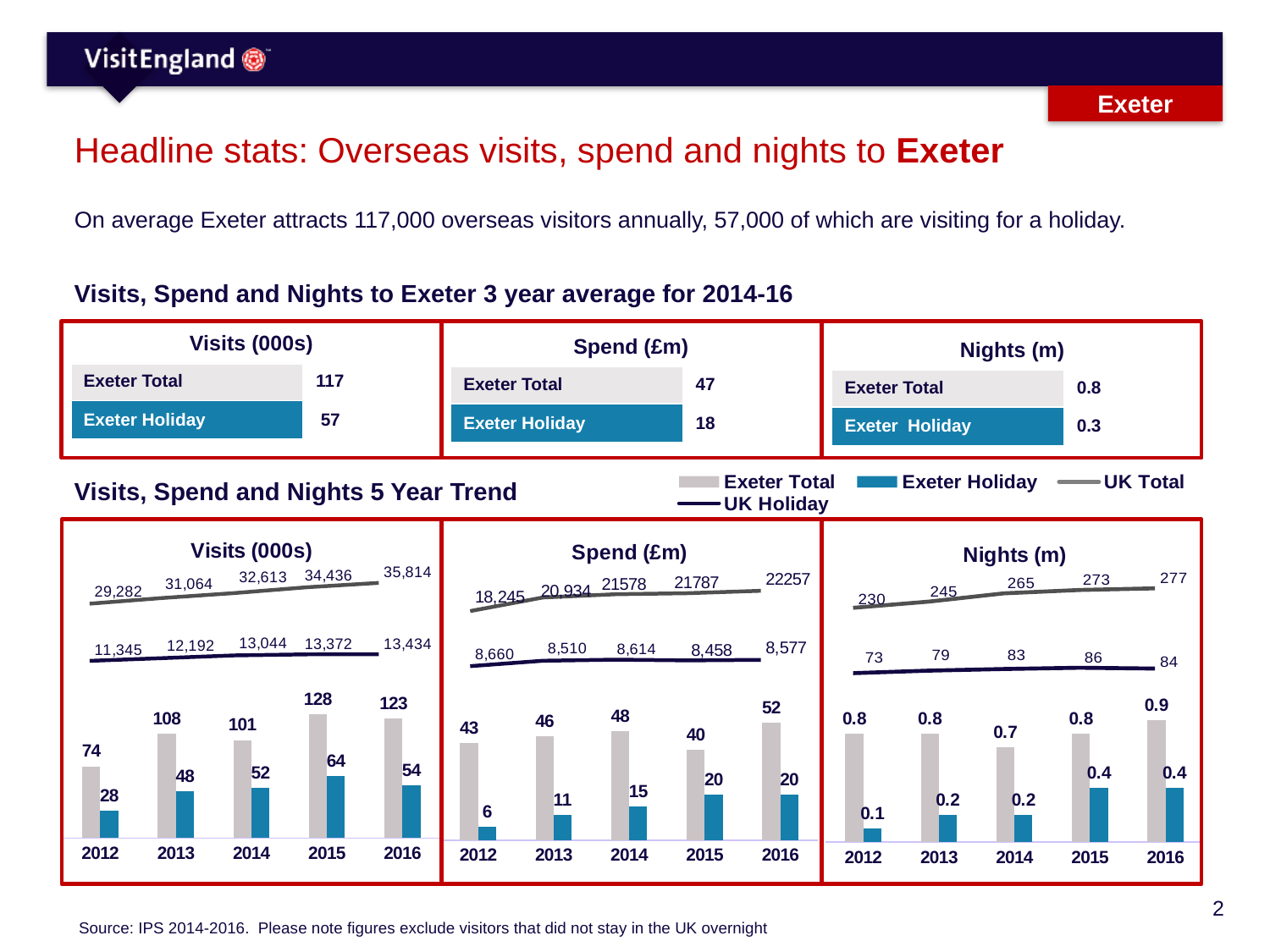
In the Nights (m) chart, is the UK Total value for 2012 larger or smaller than the UK Total value for 2016? smaller In the Spend (£m) chart, what is the UK Holiday value for 2013? 8,510 In the Spend (£m) chart, what is the difference between the Exeter Total and Exeter Holiday values for 2016? 32 In the Spend (£m) chart, which year has the lowest Exeter Total value? 2015 In the Visits (000s) chart, what is the UK Total value for 2016? 35,814 How many years are shown on the x axis of the Nights (m) chart? 5 In the Visits (000s) chart, which year has the highest Exeter Total value? 2015 How many series does the legend above the 5 Year Trend charts list? 4 In the Nights (m) chart, what is the Exeter Total value for 2014? 0.7 In the Visits (000s) chart, what is the Exeter Holiday value for 2012? 28 In the Spend (£m) chart, what is the Exeter Holiday value for 2014? 15 In the Visits (000s) chart, what is the Exeter Total value for 2015? 128